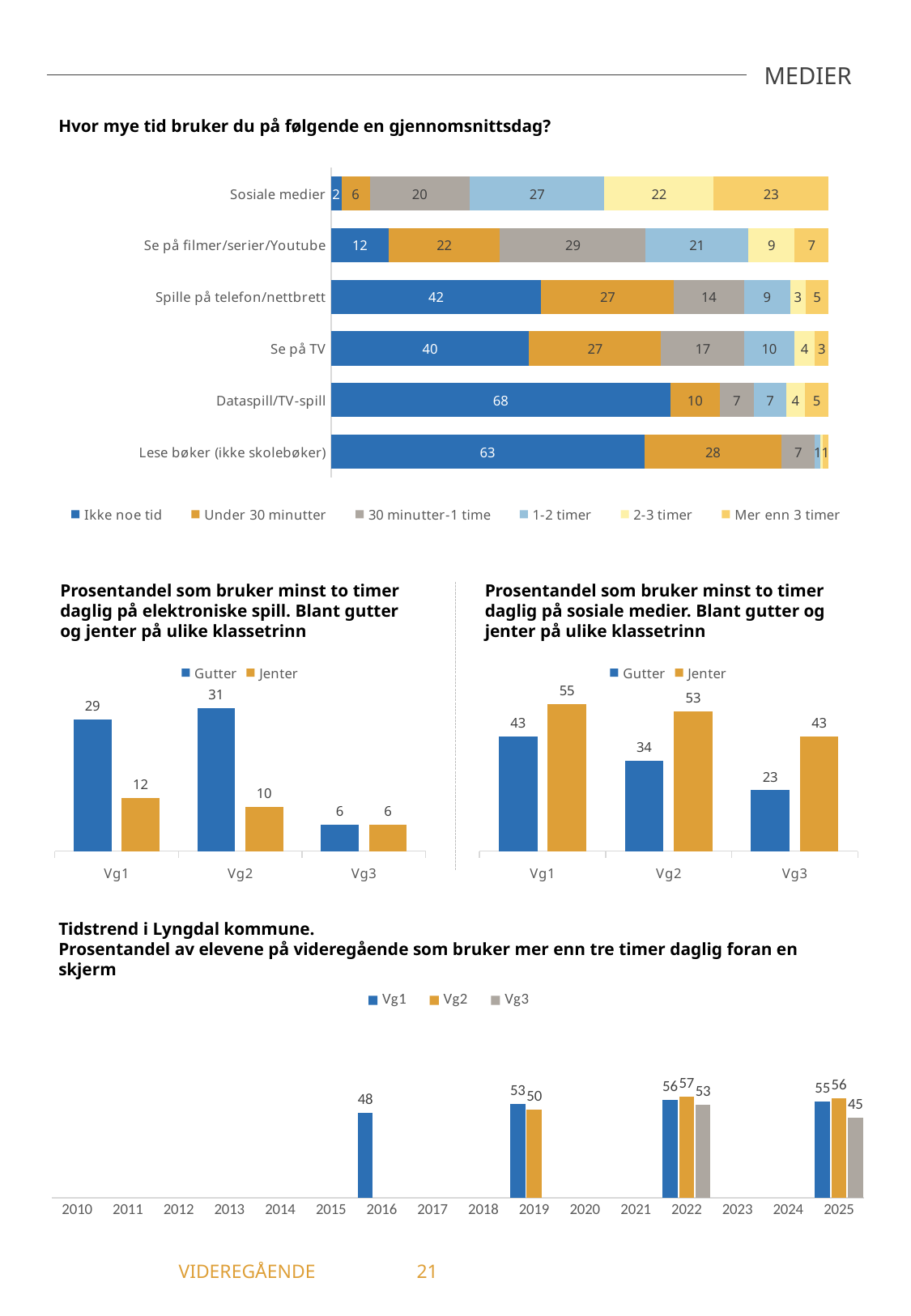
In the chart 'Hvor mye tid bruker du på følgende en gjennomsnittsdag?', how many series does the legend list? 6 In the chart 'Prosentandel som bruker minst to timer daglig på sosiale medier', do the Gutter values rise or fall from Vg1 to Vg3? fall In the chart 'Hvor mye tid bruker du på følgende en gjennomsnittsdag?', what is the value for 'Ikke noe tid' for 'Dataspill/TV-spill'? 68 In the chart 'Prosentandel som bruker minst to timer daglig på elektroniske spill', what is the difference between Gutter and Jenter at Vg1? 17 In the chart 'Prosentandel som bruker minst to timer daglig på elektroniske spill', what is the value for Gutter at Vg2? 31 In the chart 'Hvor mye tid bruker du på følgende en gjennomsnittsdag?', what is the value for 'Mer enn 3 timer' for 'Sosiale medier'? 23 In the chart 'Prosentandel som bruker minst to timer daglig på sosiale medier', what is the value for Jenter at Vg1? 55 In the chart 'Tidstrend i Lyngdal kommune', what is the value for Vg3 in 2025? 45 What kind of chart is the 'Tidstrend i Lyngdal kommune' chart? bar chart In the chart 'Prosentandel som bruker minst to timer daglig på sosiale medier', which group has the higher value at Vg3, Gutter or Jenter? Jenter In the chart 'Hvor mye tid bruker du på følgende en gjennomsnittsdag?', which category has the highest value for 'Ikke noe tid'? Dataspill/TV-spill In the chart 'Tidstrend i Lyngdal kommune', which year has the lowest value for Vg1? 2016